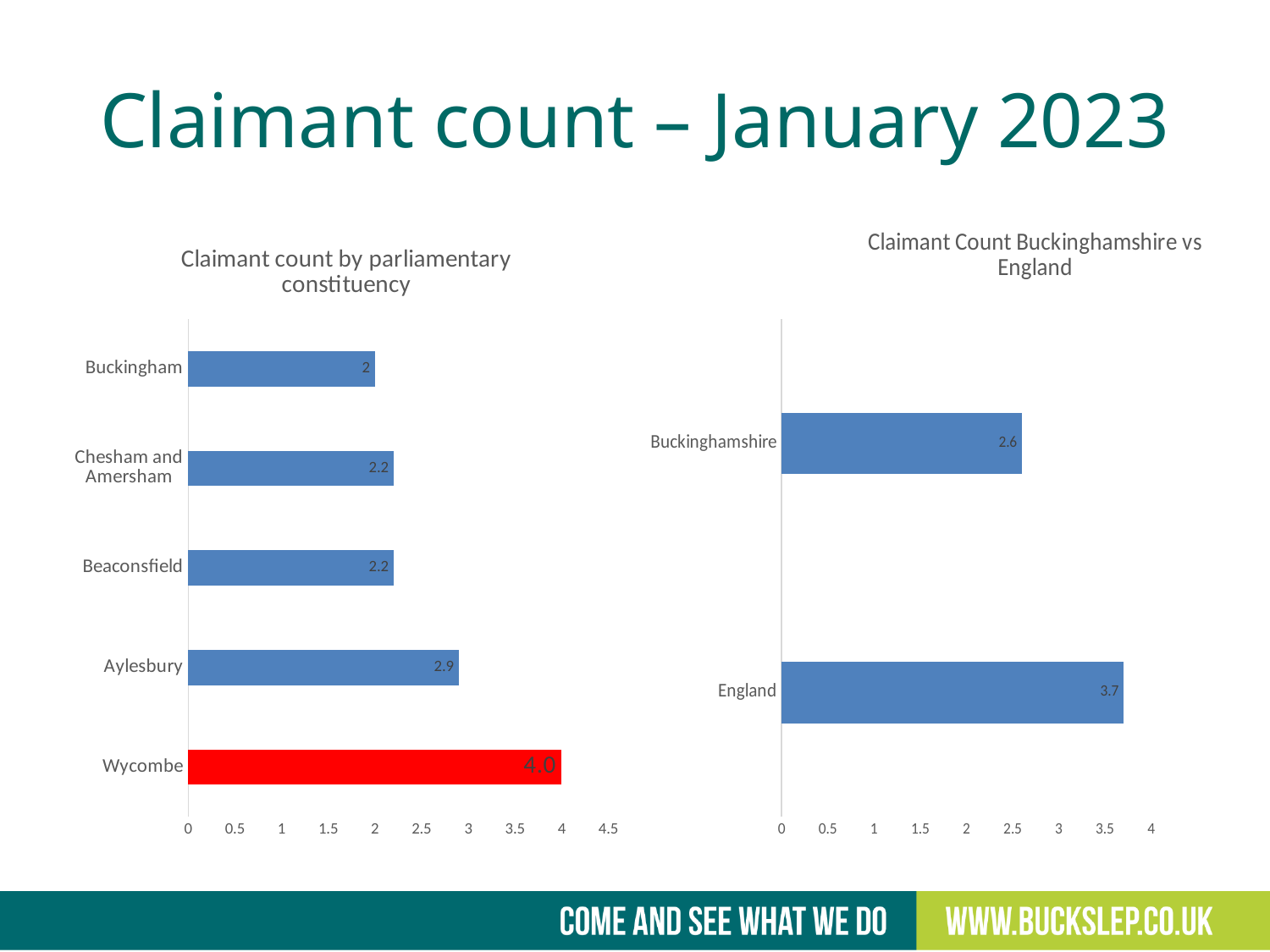
What kind of chart is the 'Claimant Count Buckinghamshire vs England' chart? Bar chart In the 'Claimant count by parliamentary constituency' chart, what is the value for Buckingham? 2 In the 'Claimant count by parliamentary constituency' chart, what is the value for Wycombe? 4.0 In the 'Claimant Count Buckinghamshire vs England' chart, what is the value for England? 3.7 In the 'Claimant count by parliamentary constituency' chart, which constituency has the highest claimant count? Wycombe In the 'Claimant count by parliamentary constituency' chart, what is the value for Aylesbury? 2.9 In the 'Claimant Count Buckinghamshire vs England' chart, what is the value for Buckinghamshire? 2.6 In the 'Claimant Count Buckinghamshire vs England' chart, which is larger, Buckinghamshire or England? England In the 'Claimant count by parliamentary constituency' chart, which constituency has the lowest claimant count? Buckingham In the 'Claimant count by parliamentary constituency' chart, which bar is coloured red? Wycombe In the 'Claimant count by parliamentary constituency' chart, how many constituencies are shown? 5 In the 'Claimant count by parliamentary constituency' chart, what is the difference between the values for Wycombe and Aylesbury? 1.1